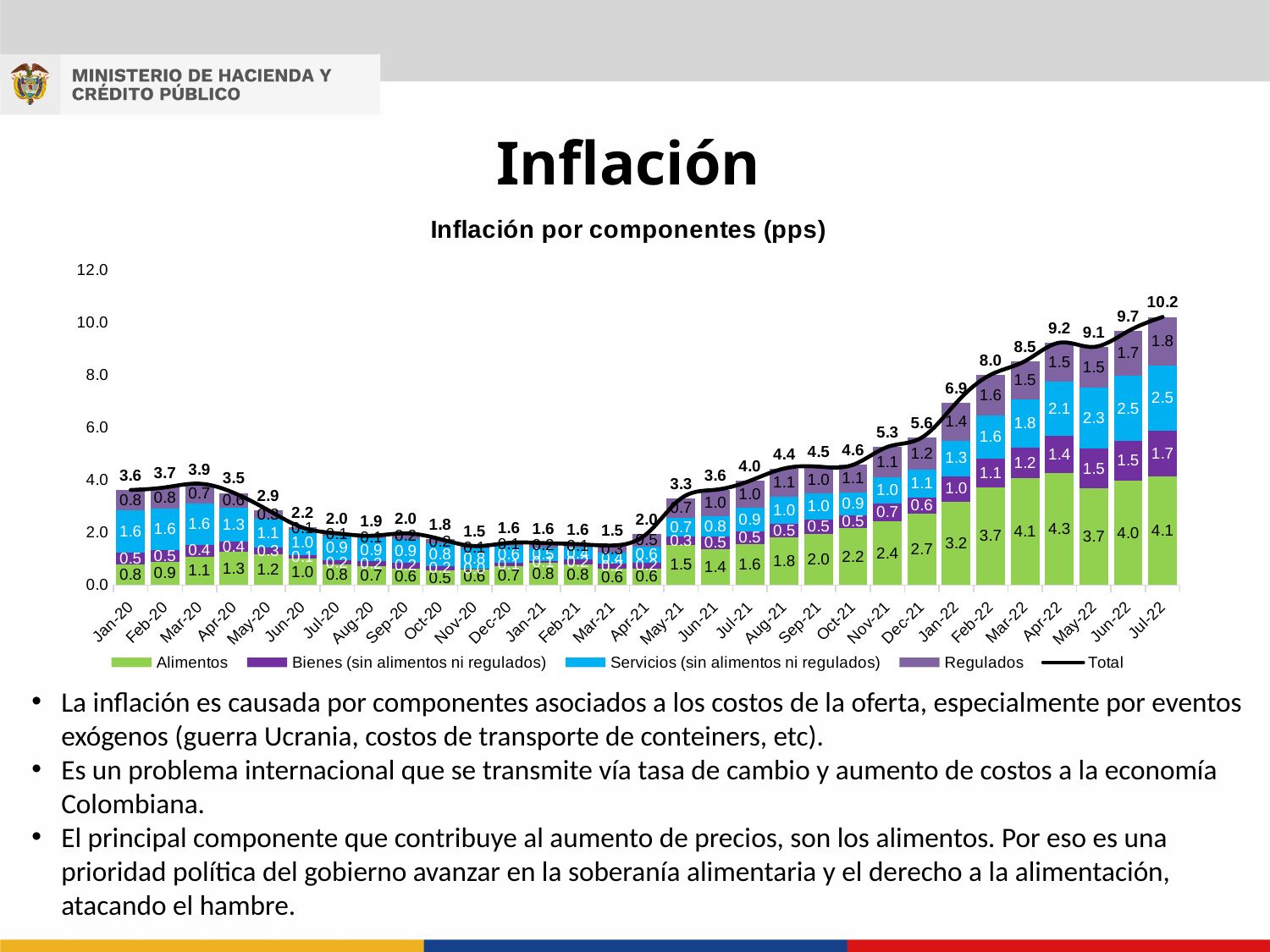
What kind of chart is shown on the slide? stacked bar chart with a line How many series does the legend list? 5 What is the difference between the Total for Jul-22 and the Total for Jan-22? 3.3 Does the Total line rise or fall from Jan-22 to Apr-22? rise What is the Regulados value for Jul-22? 1.8 In which month is the Alimentos component highest? Apr-22 In which month is the Total inflation highest? Jul-22 How many months are shown on the x axis? 31 What is the Total inflation value for Jul-22? 10.2 What is the Bienes (sin alimentos ni regulados) value for Jul-22? 1.7 What is the Alimentos value for Apr-22? 4.3 In Jul-22, which is larger: Servicios (sin alimentos ni regulados) or Regulados? Servicios (sin alimentos ni regulados)